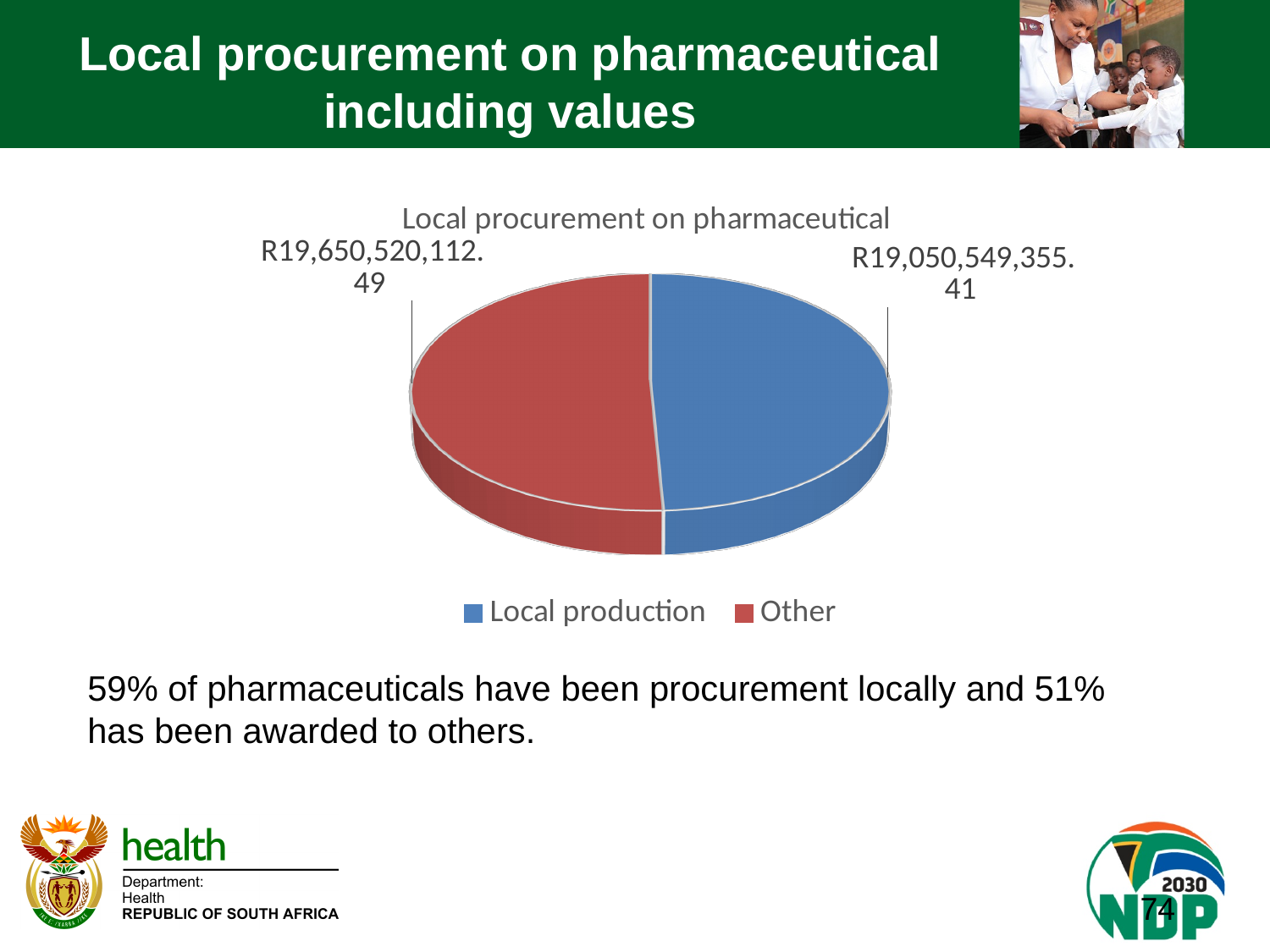
Which colour represents Local production in the pie chart? Blue Which slice of the pie has the larger value? Other What is the title of the chart? Local procurement on pharmaceutical Which slice of the pie has the smaller value? Local production What type of chart is shown on the slide? Pie chart What is the total of the two values shown on the pie chart? R38,701,069,467.90 How many slices does the pie chart have? 2 What is the difference between the value for Other and the value for Local production? R599,970,757.08 What is the value shown for Local production? R19,050,549,355.41 How many entries does the legend list? 2 Is the value for Other larger or smaller than the value for Local production? Larger What is the value shown for Other? R19,650,520,112.49